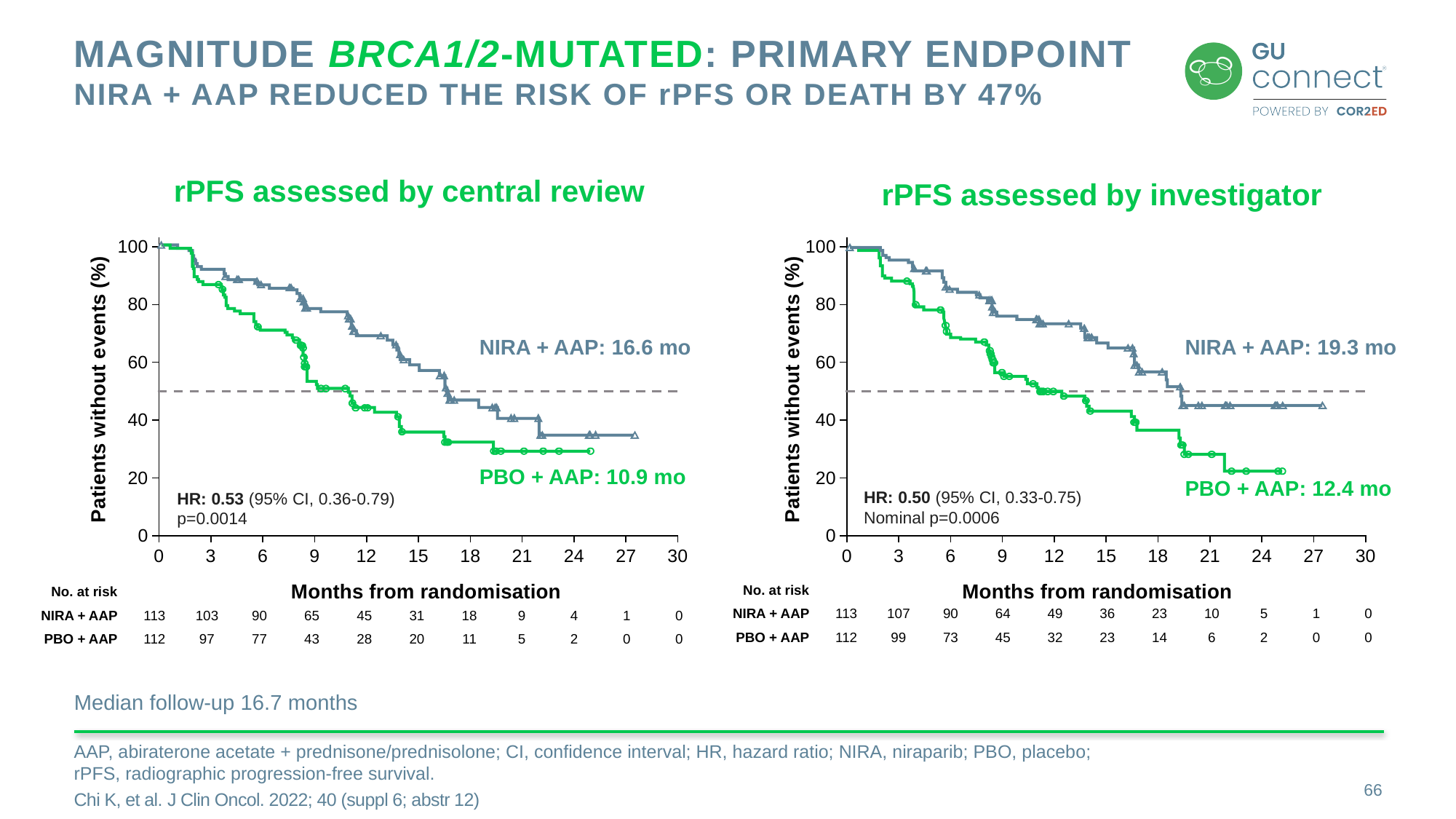
In the 'rPFS assessed by investigator' chart, is the PBO + AAP curve at 24 months greater or less than 40%? less In the 'rPFS assessed by investigator' chart, what is the hazard ratio shown? 0.50 In the 'rPFS assessed by central review' chart, is the NIRA + AAP curve at 24 months greater or less than 40%? less In the 'rPFS assessed by central review' chart, what is the median rPFS for PBO + AAP? 10.9 mo In the 'rPFS assessed by investigator' chart, how many PBO + AAP patients were at risk at 12 months? 32 In the 'rPFS assessed by central review' chart, how many NIRA + AAP patients were at risk at 9 months? 65 In the 'rPFS assessed by central review' chart, what is the difference in median rPFS between NIRA + AAP and PBO + AAP? 5.7 mo In the 'rPFS assessed by central review' chart, do the curves rise or fall as months from randomisation increase? Fall In the 'rPFS assessed by central review' chart, what is the median rPFS for NIRA + AAP? 16.6 mo In the 'rPFS assessed by investigator' chart, what is the median rPFS for NIRA + AAP? 19.3 mo In the 'rPFS assessed by investigator' chart, which arm has the longer median rPFS, NIRA + AAP or PBO + AAP? NIRA + AAP What kind of chart is used on this slide to show rPFS? Line chart (Kaplan-Meier curves)